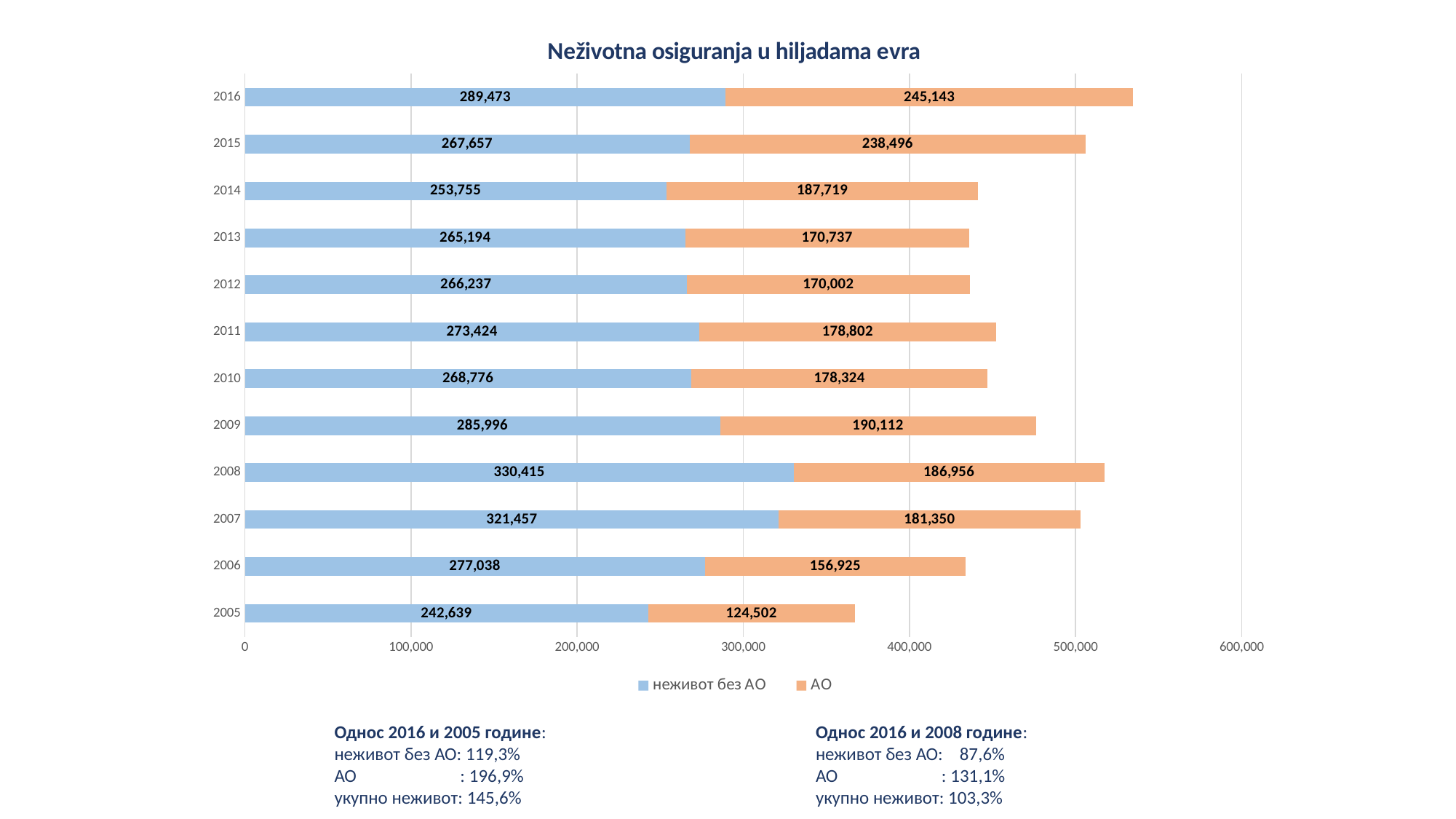
Which year has the lowest value for АО? 2005 What is the difference between the АО values for 2016 and 2015? 6,647 What is the title of the chart? Neživotna osiguranja u hiljadama evra What is the value of АО for 2005? 124,502 How many series does the legend list? 2 What kind of chart is shown on the slide? stacked bar chart Which year has the highest value for неживот без АО? 2008 What is the value of неживот без АО for 2016? 289,473 What is the total of the stacked bar for 2005? 367,141 How many years are shown on the chart? 12 Is the total of the stacked bar for 2016 greater or less than 500,000? greater Which is larger, the неживот без АО value for 2013 or for 2014? 2013